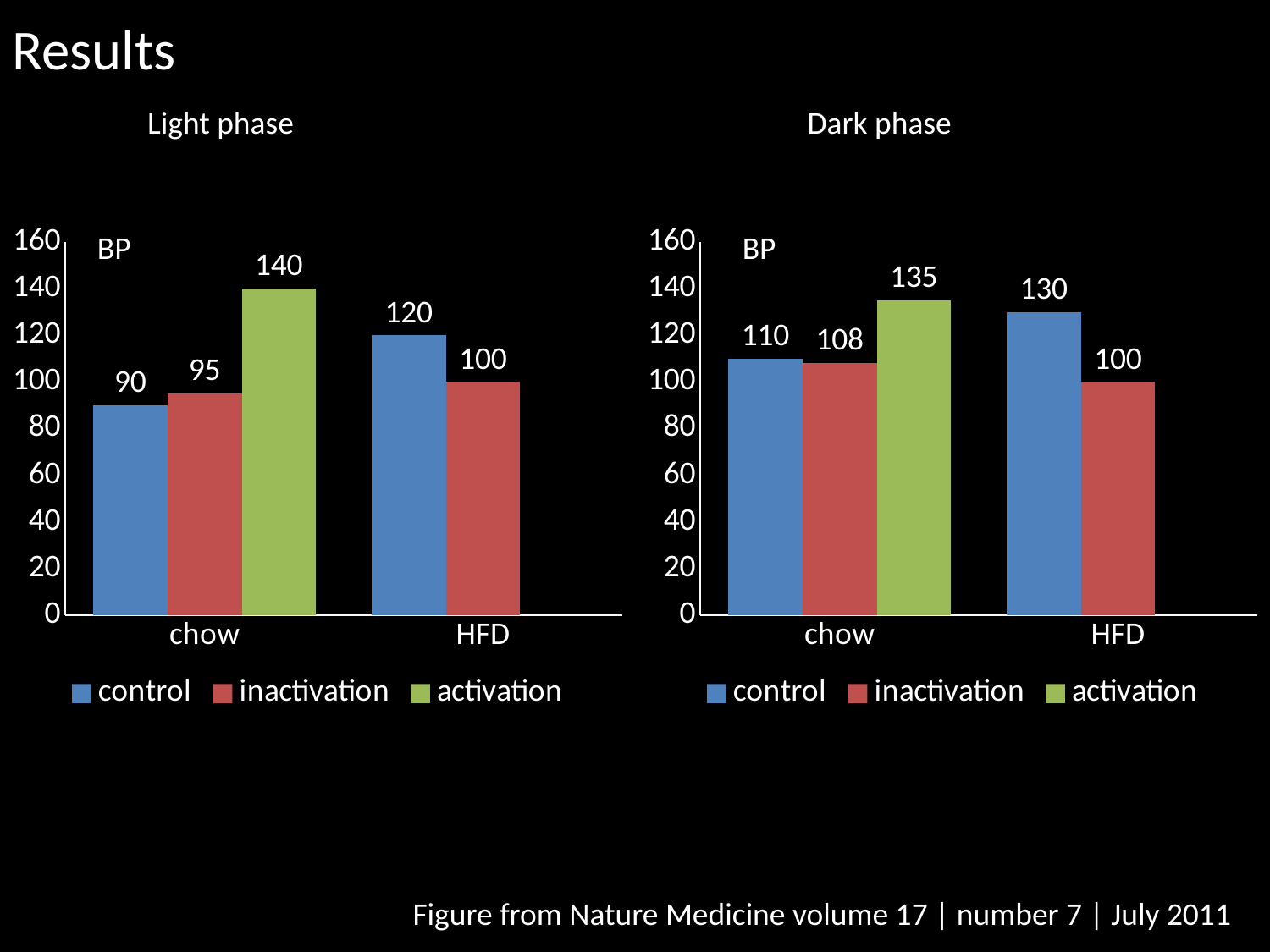
In the Dark phase chart, what is the BP value for inactivation under chow? 108 How many series does the legend of the Light phase chart list? 3 In the Light phase chart, what is the difference between the control values for HFD and chow? 30 In the Light phase chart, what is the BP value for activation under chow? 140 In the Dark phase chart, what is the BP value for control under HFD? 130 In the Dark phase chart, which series has no bar under HFD? activation In the Light phase chart, what is the BP value for inactivation under HFD? 100 In the Dark phase chart, which is larger under HFD: control or inactivation? control In the Dark phase chart, what is the difference between the activation and control values under chow? 25 What kind of chart is the Dark phase chart? bar chart In the Light phase chart, which bar has the lowest value? control under chow In the Light phase chart, which bar has the highest value? activation under chow